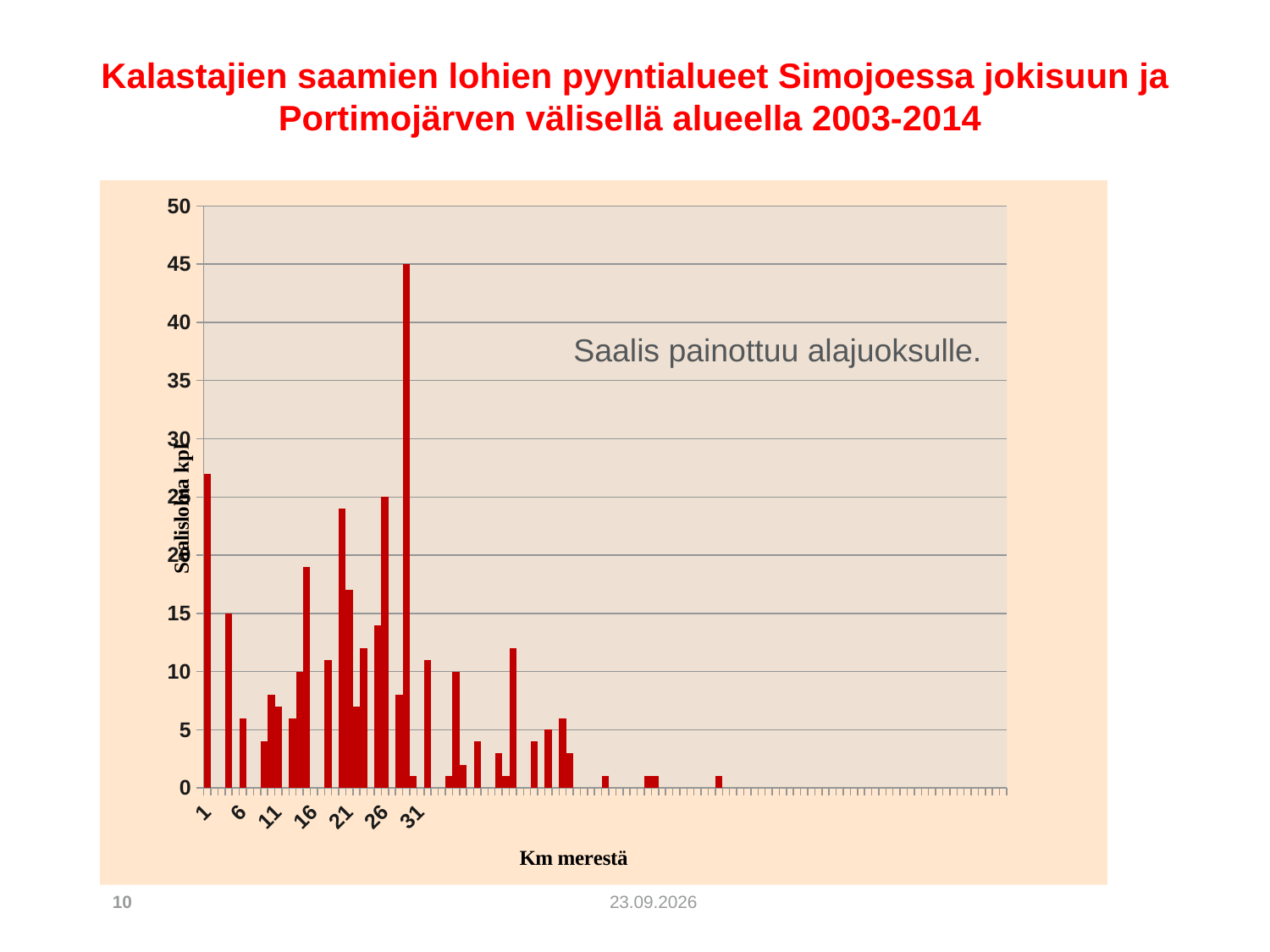
Is the value for 1 km from the sea greater or less than 30? less Is the value of the tallest bar greater or less than 40? greater Is the value for 1 km from the sea greater or less than 20? greater Overall, do the catch values rise or fall as the distance from the sea increases along the x axis? fall What is the value of the tallest bar in the chart? 45 Which has the larger value, 1 km from the sea or 11 km from the sea? 1 km What text annotation is written inside the chart area? Saalis painottuu alajuoksulle. What is the title of the x axis of the chart? Km merestä What kind of chart is shown on the slide? bar chart